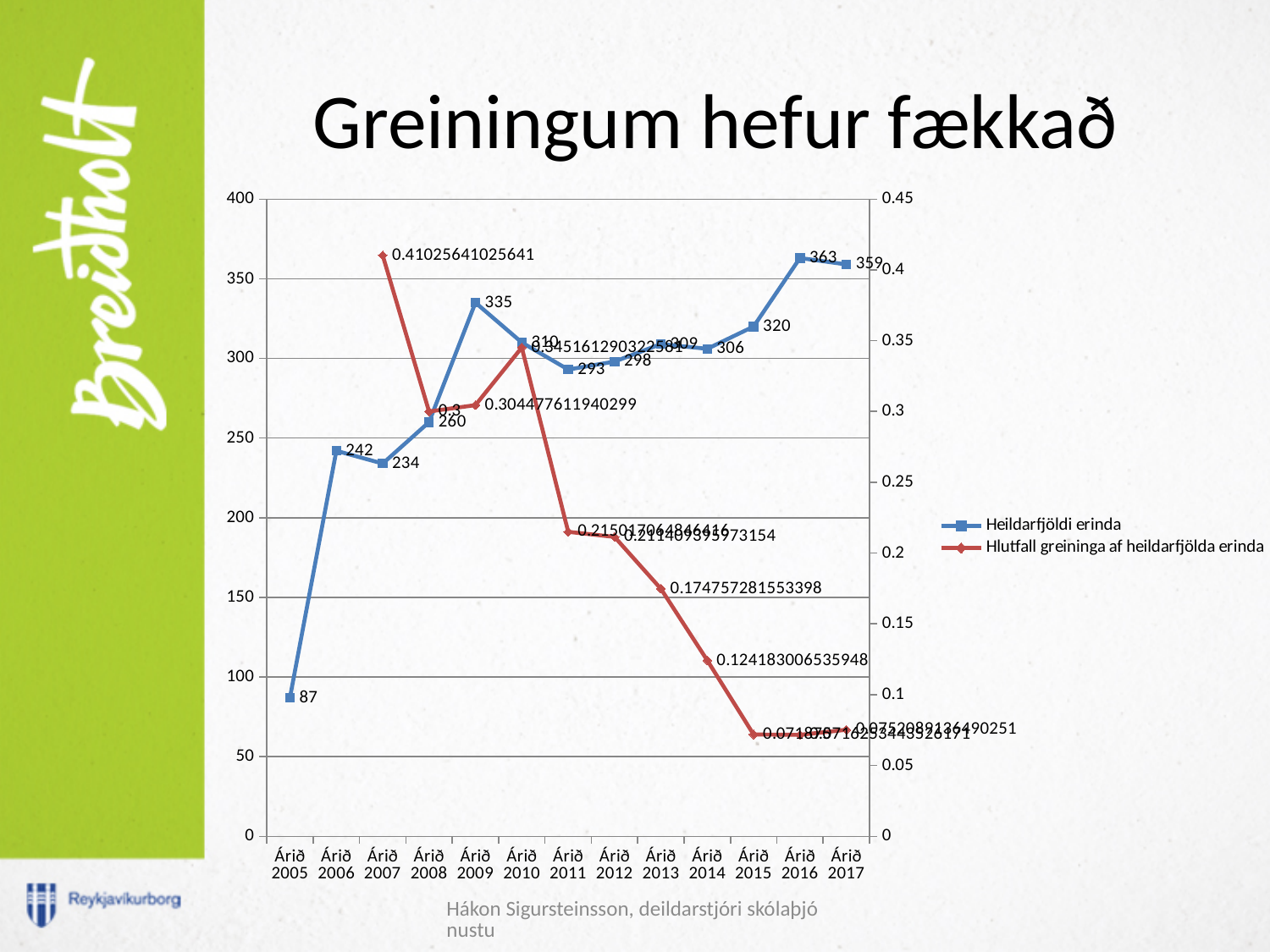
How many series does the legend list? 2 What is the value of Heildarfjöldi erinda for Árið 2009? 335 How many years are shown on the x axis? 13 What is the value of Heildarfjöldi erinda for Árið 2005? 87 What is the value of Hlutfall greininga af heildarfjölda erinda for Árið 2007? 0.41025641025641 What kind of chart is shown on the slide? line chart In which year is Heildarfjöldi erinda highest? Árið 2016 In which year is Heildarfjöldi erinda lowest? Árið 2005 What is the value of Hlutfall greininga af heildarfjölda erinda for Árið 2014? 0.124183006535948 What is the difference between Heildarfjöldi erinda in Árið 2016 and Árið 2017? 4 Does Hlutfall greininga af heildarfjölda erinda generally rise or fall from Árið 2007 to Árið 2017? fall Which is larger, Heildarfjöldi erinda in Árið 2006 or in Árið 2007? Árið 2006